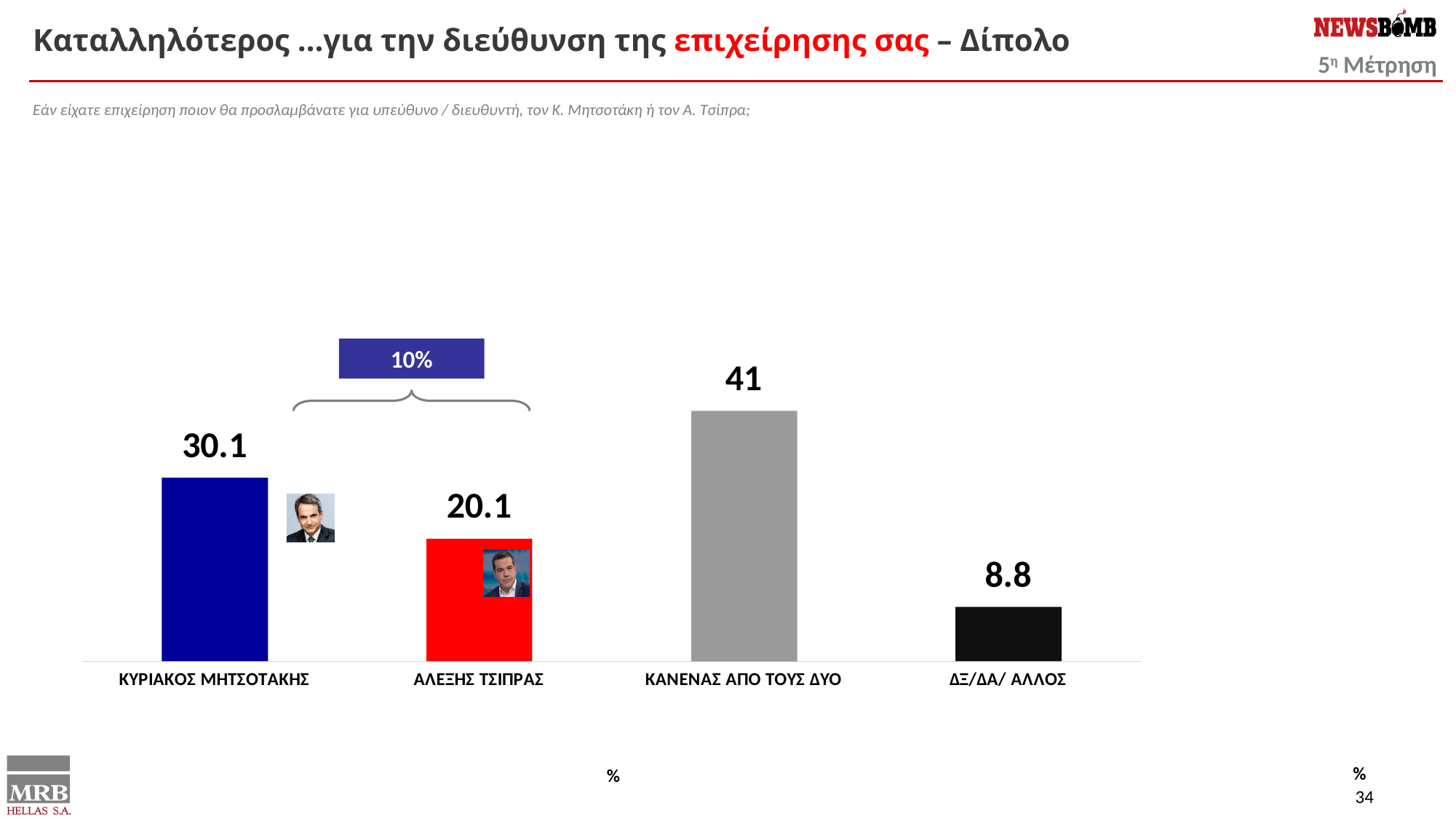
What is the difference between the values for ΚΑΝΕΝΑΣ ΑΠΟ ΤΟΥΣ ΔΥΟ and ΔΞ/ΔΑ/ ΑΛΛΟΣ? 32.2 What is the value for ΑΛΕΞΗΣ ΤΣΙΠΡΑΣ? 20.1 Which is larger, the value for ΚΥΡΙΑΚΟΣ ΜΗΤΣΟΤΑΚΗΣ or the value for ΑΛΕΞΗΣ ΤΣΙΠΡΑΣ? ΚΥΡΙΑΚΟΣ ΜΗΤΣΟΤΑΚΗΣ What is the value for ΚΑΝΕΝΑΣ ΑΠΟ ΤΟΥΣ ΔΥΟ? 41 Which category has the highest value? ΚΑΝΕΝΑΣ ΑΠΟ ΤΟΥΣ ΔΥΟ What is the difference between the values for ΚΥΡΙΑΚΟΣ ΜΗΤΣΟΤΑΚΗΣ and ΑΛΕΞΗΣ ΤΣΙΠΡΑΣ? 10 What value is shown in the blue box above the bracket between the first two bars? 10% Which category has the lowest value? ΔΞ/ΔΑ/ ΑΛΛΟΣ What is the value for ΔΞ/ΔΑ/ ΑΛΛΟΣ? 8.8 What kind of chart is shown on the slide? Bar chart What is the value for ΚΥΡΙΑΚΟΣ ΜΗΤΣΟΤΑΚΗΣ? 30.1 How many categories are shown in the chart? 4